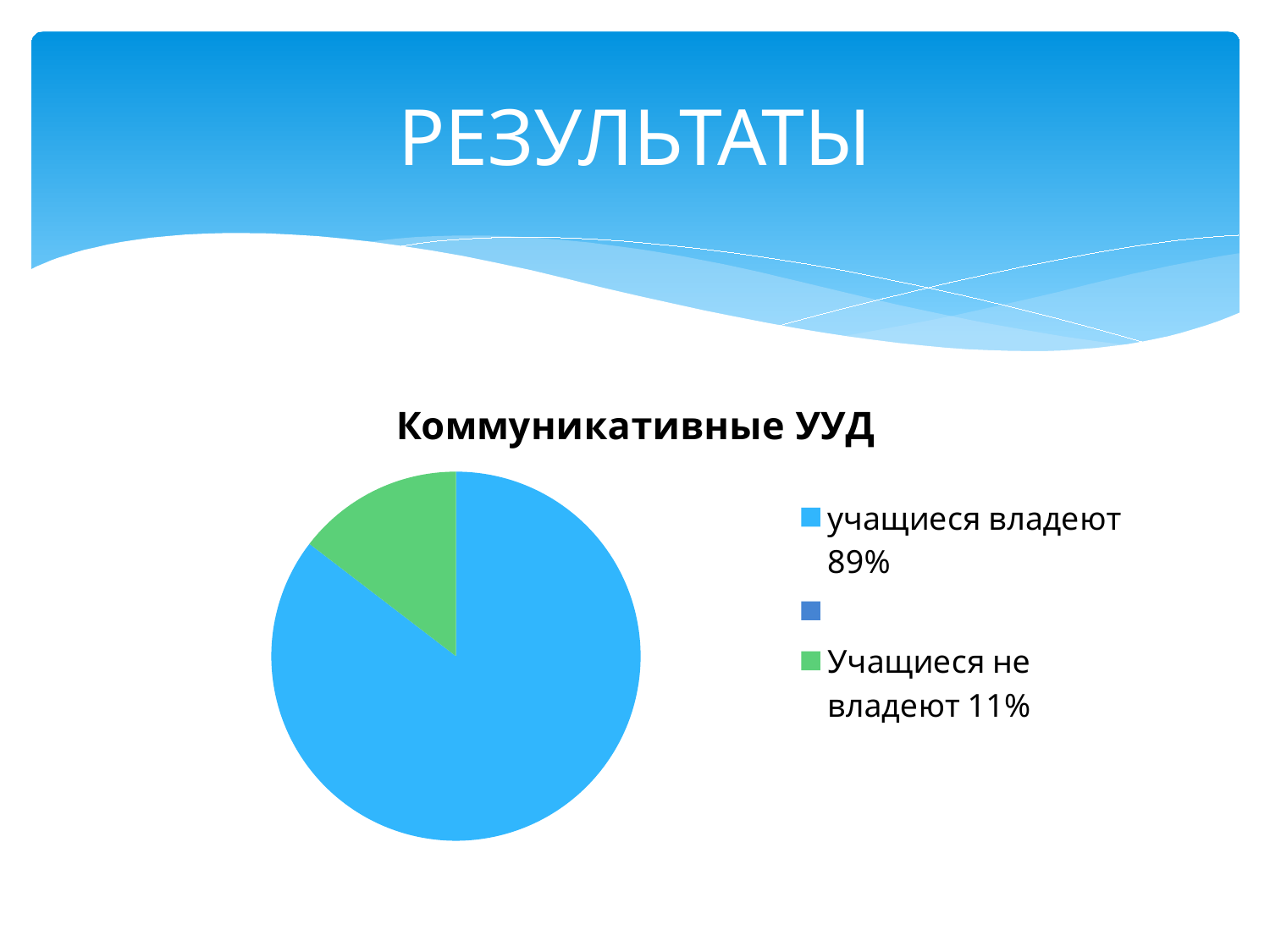
What share of the pie does the green slice represent? 11% What is the title of the chart? Коммуникативные УУД What type of chart is shown on the slide? pie chart What colour is the slice for "Учащиеся не владеют"? green How many slices are visible in the pie chart? 2 Which category has the largest slice of the pie? учащиеся владеют Which is larger: the share for "учащиеся владеют" or the share for "Учащиеся не владеют"? учащиеся владеют What is the difference in percentage points between the "учащиеся владеют" slice and the "Учащиеся не владеют" slice? 78% Which category has the smallest slice of the pie? Учащиеся не владеют What percentage of the pie is labelled "учащиеся владеют"? 89% What percentage of the pie is labelled "Учащиеся не владеют"? 11%